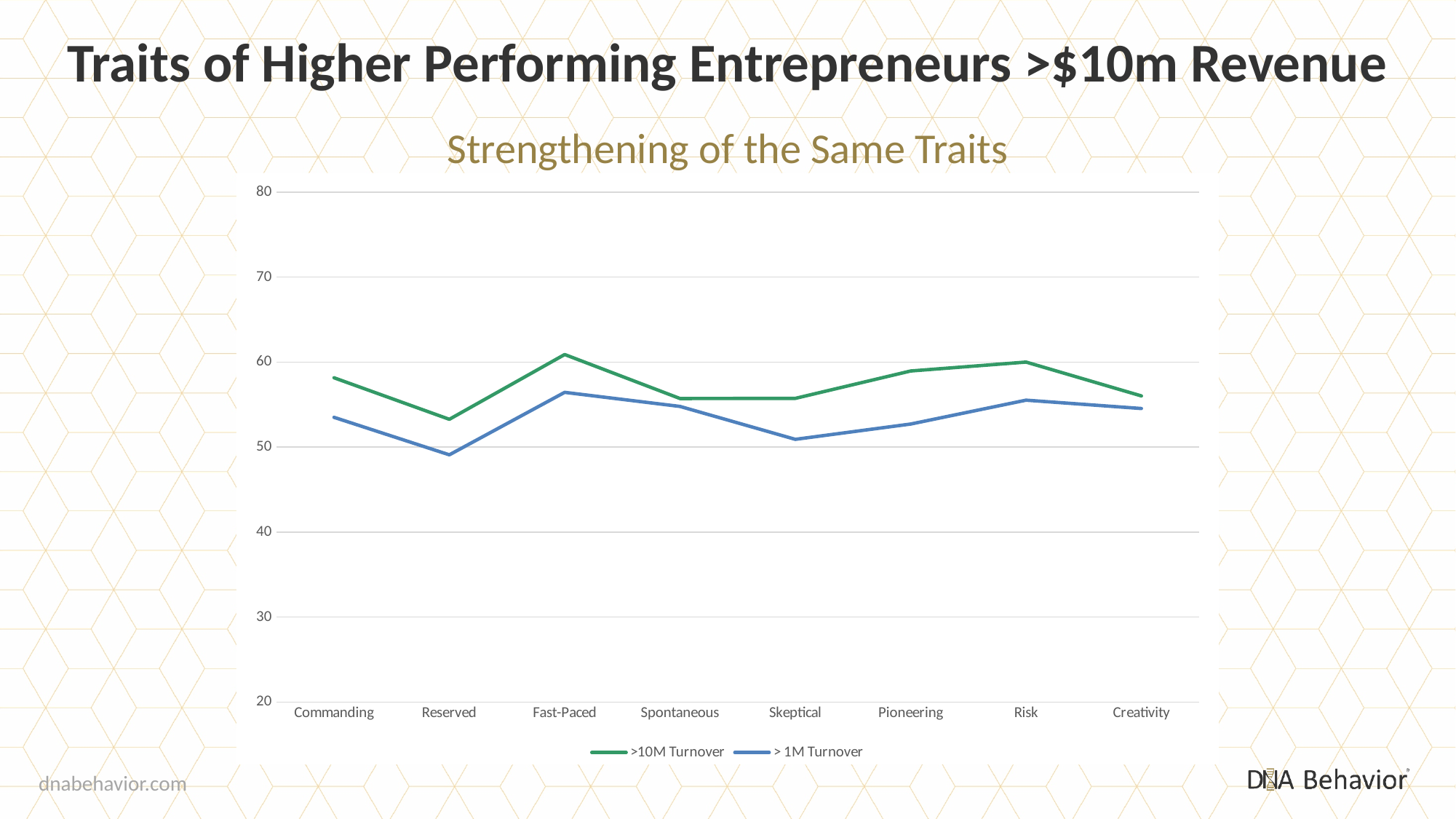
What kind of chart is shown on the slide? line chart Is the > 1M Turnover value for Skeptical greater or less than 60? less Which trait has the lowest value for the > 1M Turnover series? Reserved Which trait has the lowest value for the >10M Turnover series? Reserved How many traits are plotted along the x axis? 8 For Commanding, which series has the larger value, >10M Turnover or > 1M Turnover? >10M Turnover What is the title of the chart? Strengthening of the Same Traits Do the values for both series rise or fall from Commanding to Reserved? fall How many series does the legend list? 2 Which trait has the highest value for the >10M Turnover series? Fast-Paced Is the > 1M Turnover value for Reserved greater or less than 50? less Is the >10M Turnover value for Fast-Paced greater or less than 60? greater